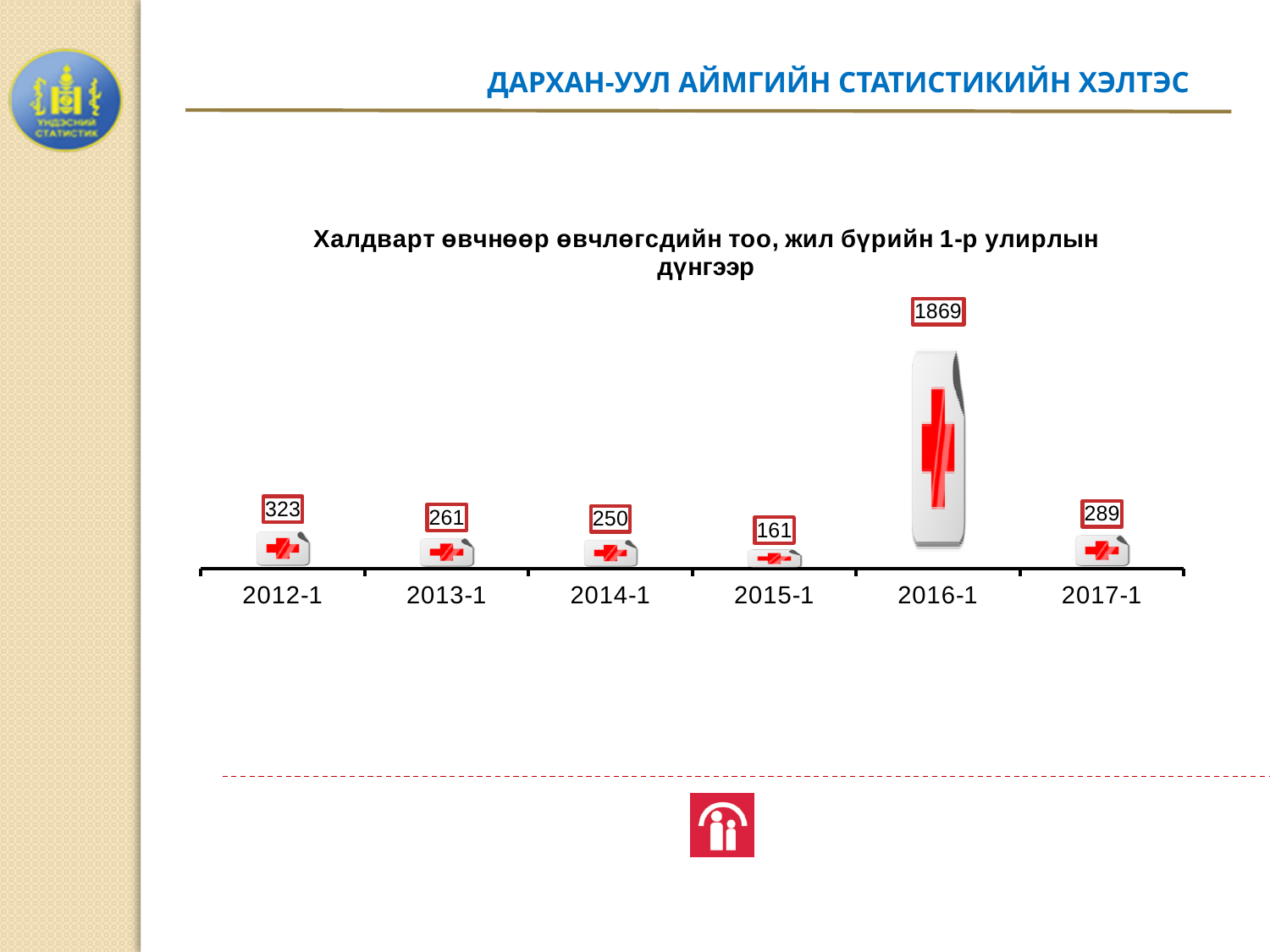
How many periods are shown on the x axis? 6 Do the values rise or fall from 2012-1 to 2015-1? fall Which is larger, the value for 2013-1 or the value for 2014-1? 2013-1 What is the value for 2015-1? 161 What is the difference between the values for 2016-1 and 2017-1? 1580 What is the difference between the values for 2012-1 and 2013-1? 62 Which period has the highest value? 2016-1 What is the value for 2012-1? 323 What is the value for 2017-1? 289 What is the value for 2016-1? 1869 What kind of chart is this? bar chart Which period has the lowest value? 2015-1